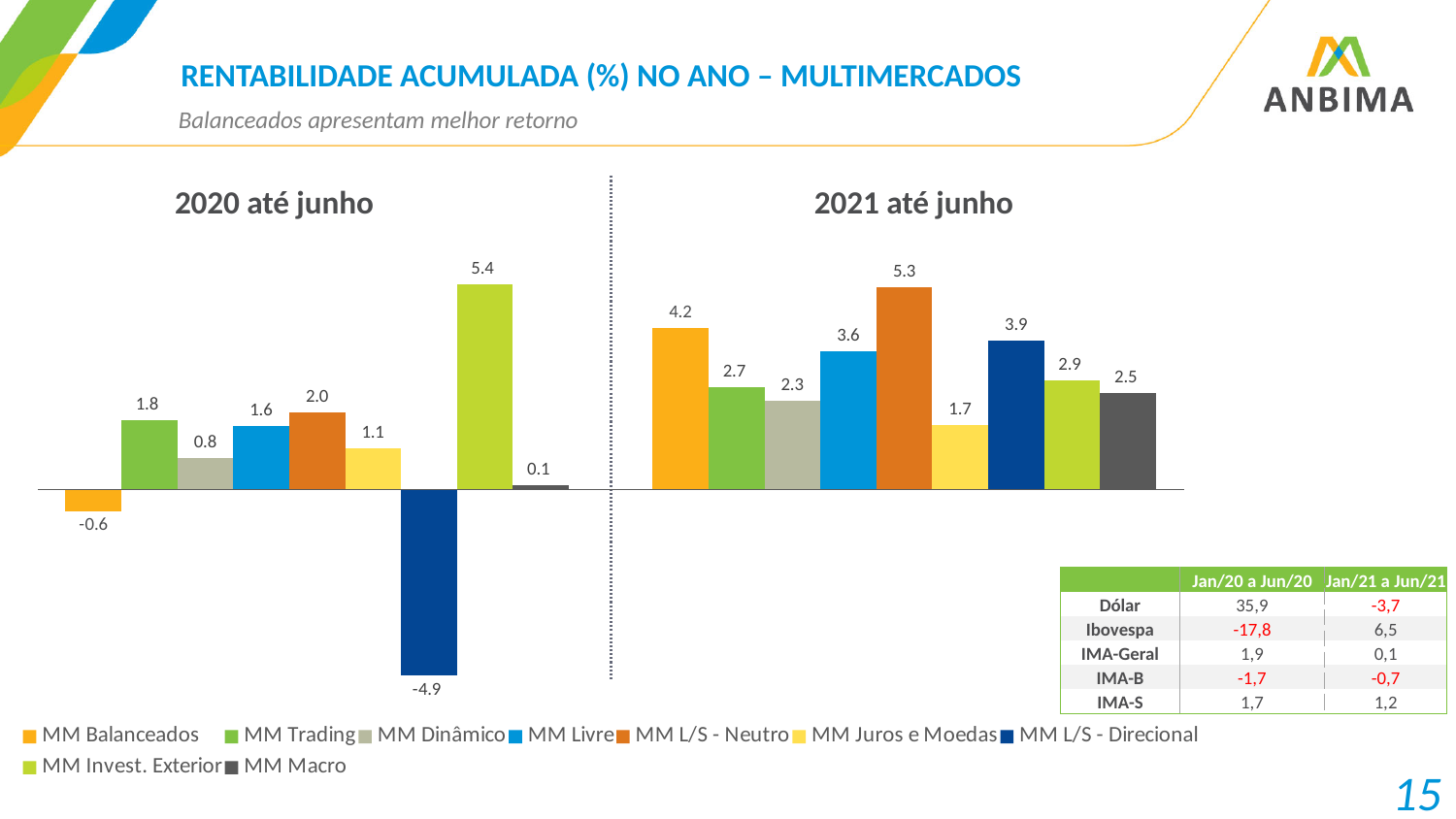
What is the value for MM Balanceados in the 2020 até junho group? -0.6 What is the value for MM Invest. Exterior in the 2020 até junho group? 5.4 What kind of chart is shown on the slide? Bar chart What is the difference between the MM Balanceados values for 2021 até junho and 2020 até junho? 4.8 What is the title of the chart on the slide? RENTABILIDADE ACUMULADA (%) NO ANO – MULTIMERCADOS What is the value for MM Macro in the 2020 até junho group? 0.1 Which series has the lowest value in the 2021 até junho group? MM Juros e Moedas Which is larger in the 2021 até junho group: MM Livre or MM L/S - Direcional? MM L/S - Direcional How many series does the legend list? 9 What is the value for MM L/S - Neutro in the 2021 até junho group? 5.3 Which series has the lowest value in the 2020 até junho group? MM L/S - Direcional Which series has the highest value in the 2021 até junho group? MM L/S - Neutro